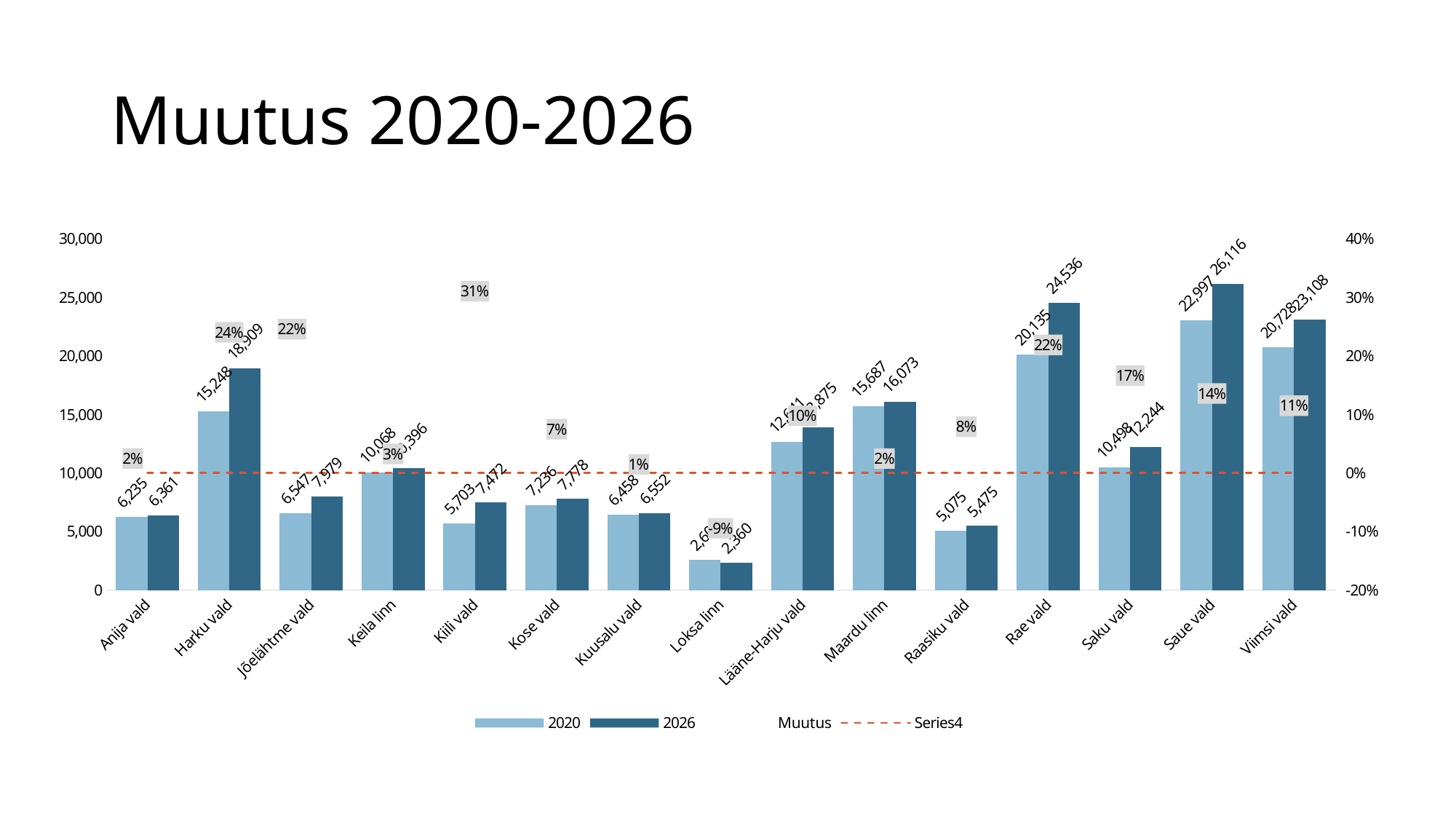
Which is larger, the 2020 value for Saue vald or the 2020 value for Viimsi vald? Saue vald Which category shows the highest percentage change (Muutus)? Kiili vald What type of chart is shown on the slide? Combination bar and line chart Is the 2026 value for Saku vald greater or less than 10,000? greater What is the 2020 value for Harku vald? 15,248 How many entries does the legend list? 4 Which category has the lowest 2026 value? Loksa linn What is the 2026 value for Rae vald? 24,536 Which category has the highest 2026 value? Saue vald What percentage change (Muutus) is shown for Kiili vald? 31% How many categories are shown on the x axis? 15 What is the difference between the 2026 and 2020 values for Rae vald? 4,401